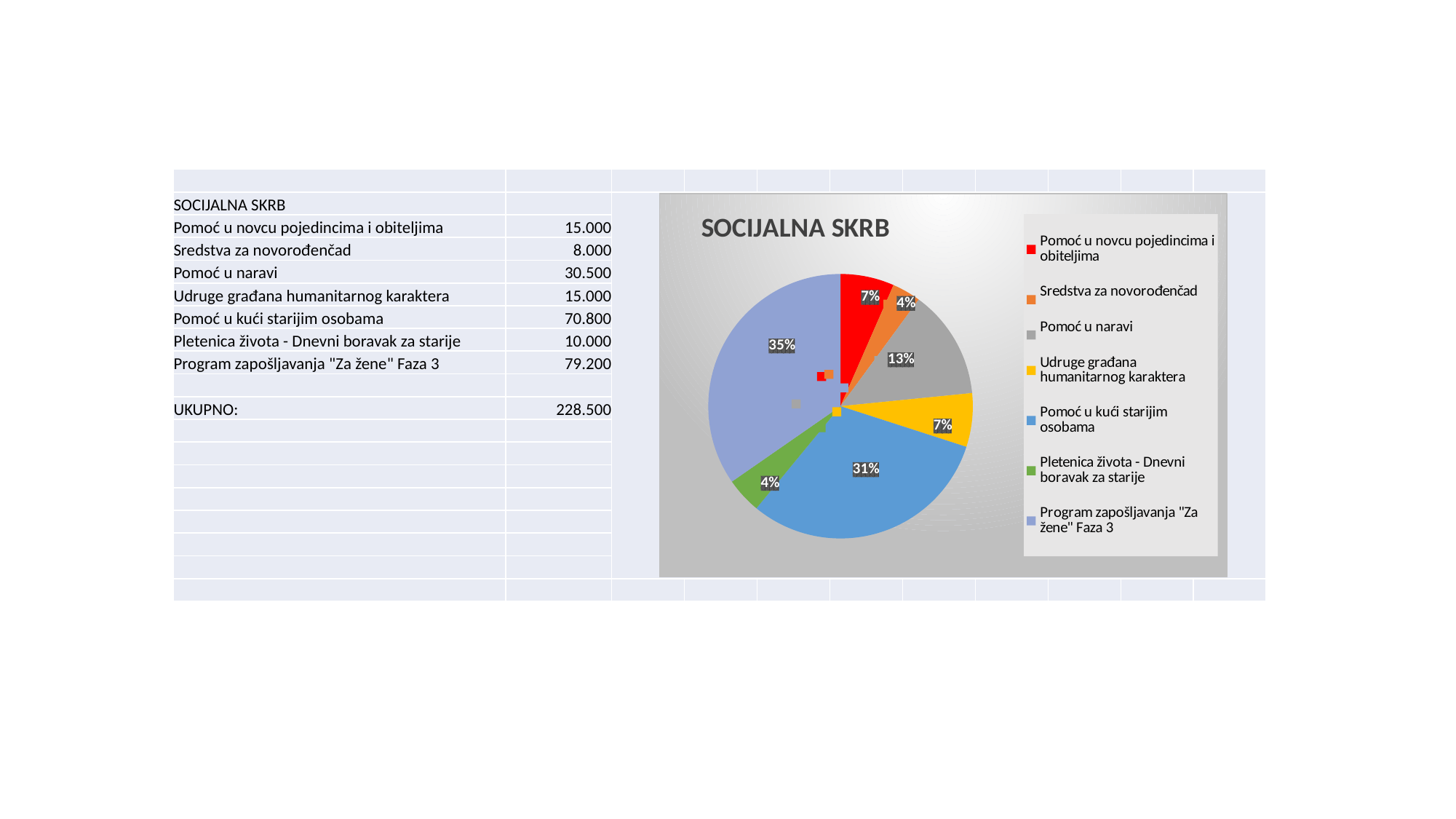
What is the title of the chart? SOCIJALNA SKRB What kind of chart is shown on the slide? pie chart What share of the pie does "Pomoć u naravi" take? 13% What share of the pie does "Sredstva za novorođenčad" take? 4% How many entries does the chart legend list? 7 What colour is the slice for "Pomoć u naravi"? gray What share of the pie does "Pomoć u kući starijim osobama" take? 31% How many slices does the pie chart have? 7 Which category has the largest slice of the pie? Program zapošljavanja "Za žene" Faza 3 By how many percentage points does the "Program zapošljavanja "Za žene" Faza 3" slice exceed the "Pomoć u kući starijim osobama" slice? 4 Which slice is larger: "Pomoć u kući starijim osobama" or "Pomoć u naravi"? Pomoć u kući starijim osobama